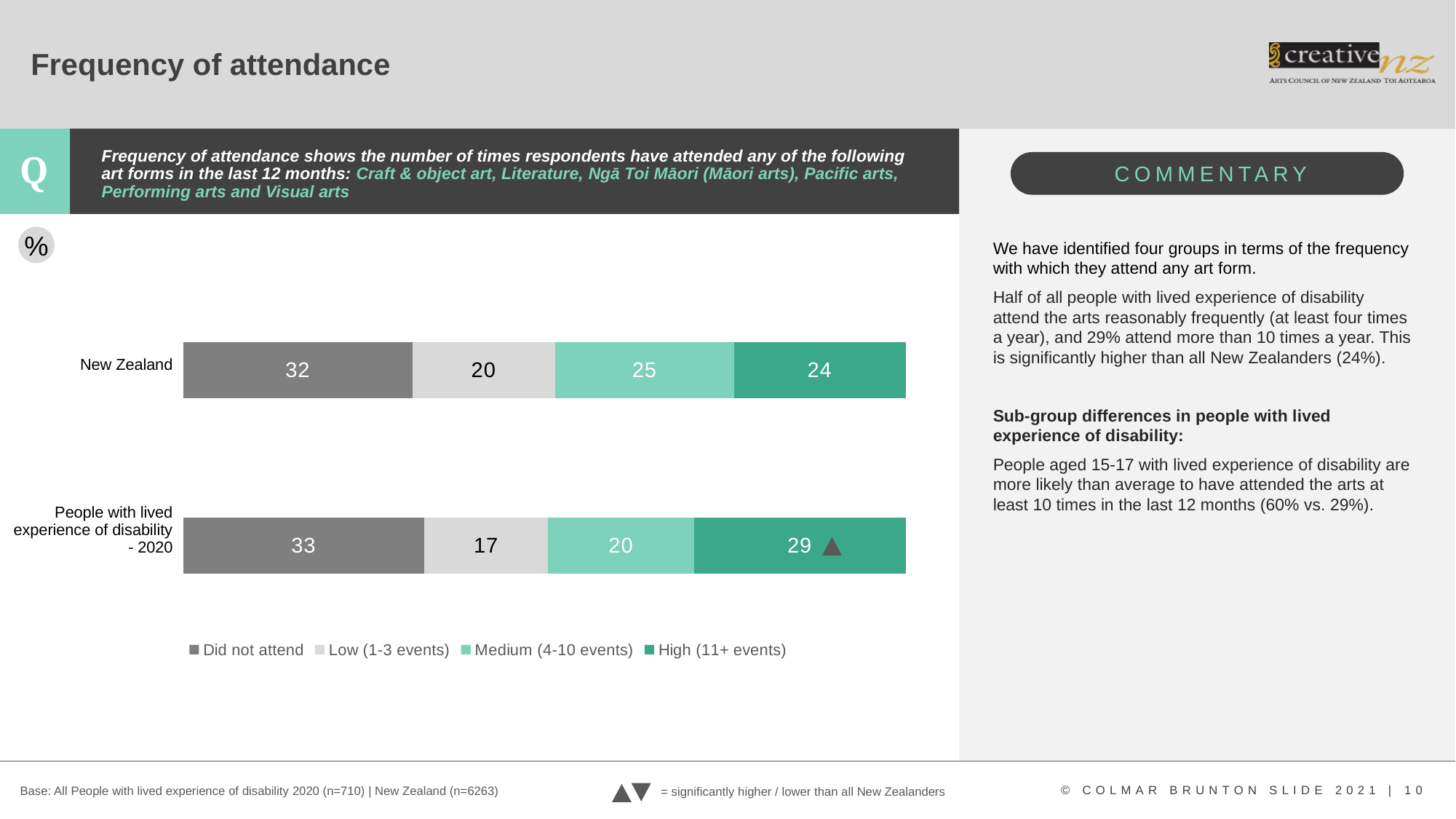
Which series has the lowest value in the People with lived experience of disability - 2020 bar? Low (1-3 events) What is the Low (1-3 events) value for People with lived experience of disability - 2020? 17 What is the total of the stacked bar for New Zealand? 101 What kind of chart is shown on the slide? Stacked bar chart Which group has the larger Medium (4-10 events) value, New Zealand or People with lived experience of disability - 2020? New Zealand How many categories (bars) are shown in the chart? 2 What percentage of New Zealand respondents did not attend any art form? 32 Which series has the highest value in the New Zealand bar? Did not attend What is the difference between the High (11+ events) values for People with lived experience of disability - 2020 and New Zealand? 5 What is the Medium (4-10 events) value for New Zealand? 25 What is the High (11+ events) value for People with lived experience of disability - 2020? 29 How many series does the legend list? 4